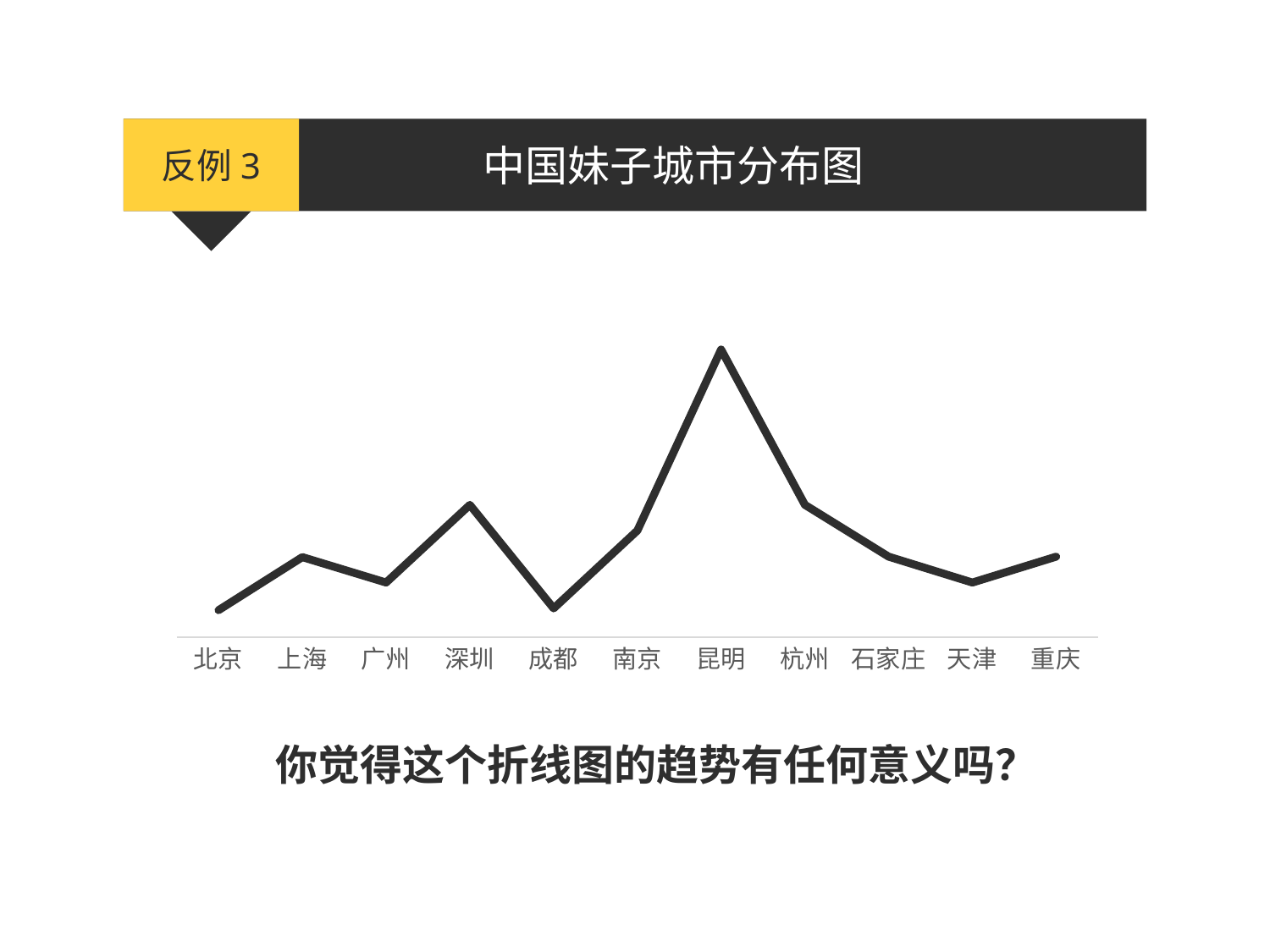
Which is larger, the value for 深圳 or the value for 广州? 深圳 Which city is the first category on the x axis? 北京 What is the title of the chart shown on the slide? 中国妹子城市分布图 Do the values rise or fall from 昆明 to 天津? Fall Which city has the highest value in the chart? 昆明 Do the values rise or fall from 成都 to 昆明? Rise What kind of chart is shown on the slide? Line chart How many cities are plotted along the x axis of the chart? 11 Which is larger, the value for 昆明 or the value for 深圳? 昆明 Which is larger, the value for 南京 or the value for 成都? 南京